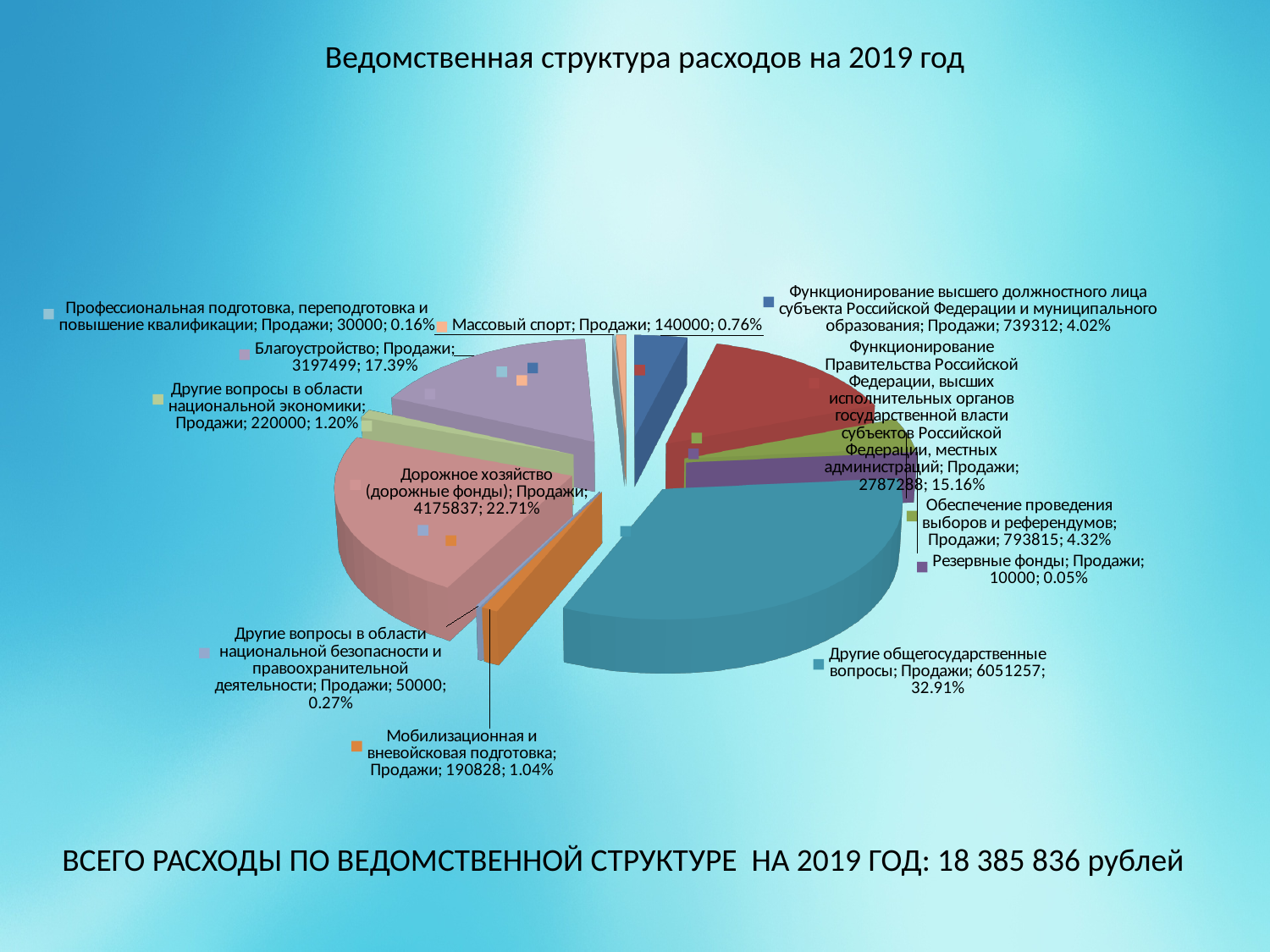
How many categories (slices) does the pie chart have? 12 What is the difference between the values for Дорожное хозяйство (дорожные фонды) and Благоустройство? 978338 What share of the pie does Другие общегосударственные вопросы represent? 32.91% What kind of chart is shown on the slide? Pie chart What is the value for Благоустройство? 3197499 Which category has the smallest share of the pie? Резервные фонды Which category has the largest share of the pie? Другие общегосударственные вопросы What share of the pie does Обеспечение проведения выборов и референдумов represent? 4.32% Which is larger: the value for Мобилизационная и вневойсковая подготовка or the value for Другие вопросы в области национальной экономики? Другие вопросы в области национальной экономики What is the value for Массовый спорт? 140000 What is the title of the chart? Ведомственная структура расходов на 2019 год What is the value for Дорожное хозяйство (дорожные фонды)? 4175837